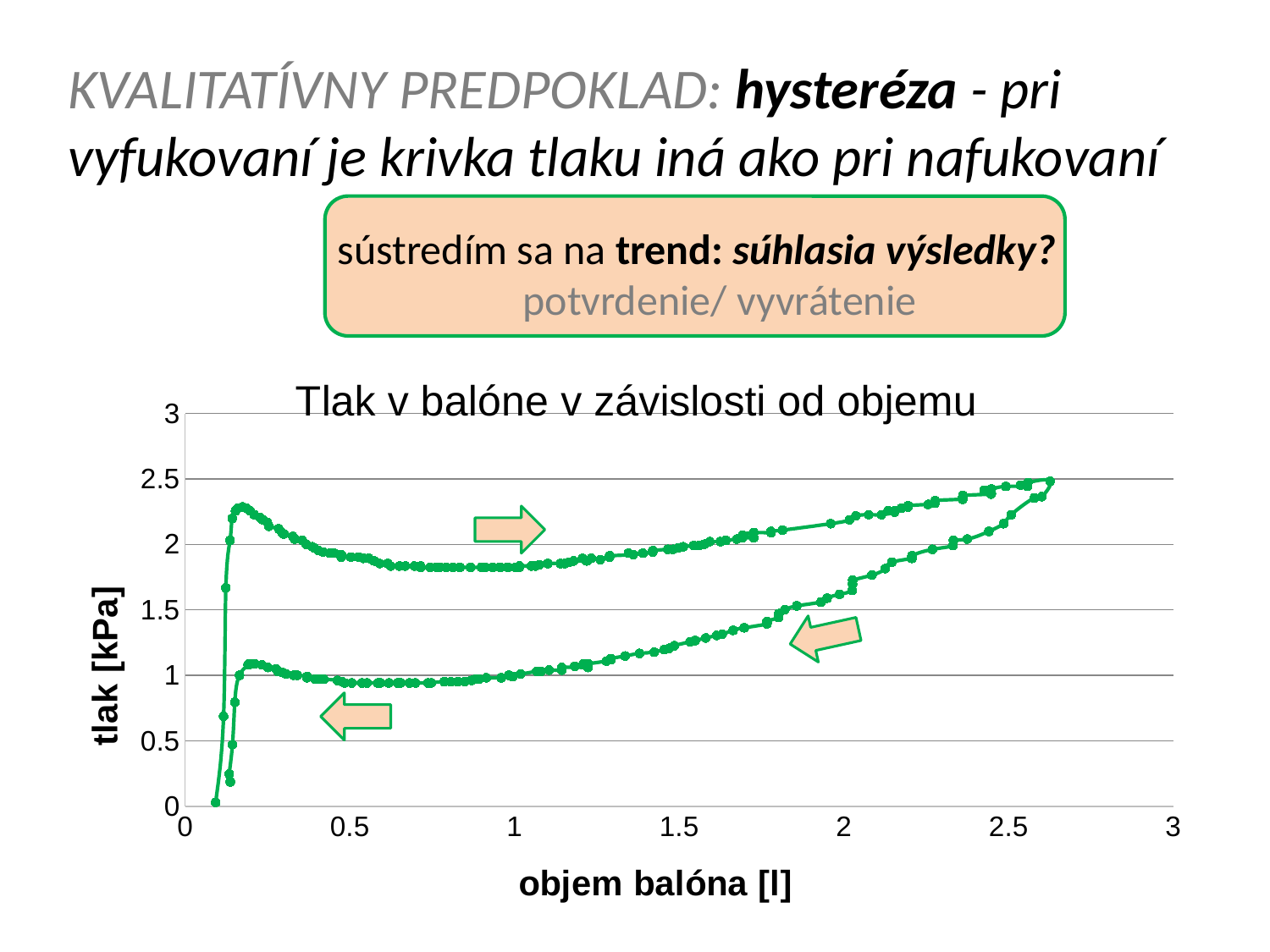
On the upper curve, is the pressure at a volume of 1 l greater or less than 2 kPa? less What is the title of the chart? Tlak v balóne v závislosti od objemu Is the highest pressure reached on the chart greater or less than 2 kPa? greater What is the label of the vertical axis of the chart? tlak [kPa] Is the highest pressure reached on the chart greater or less than 3 kPa? less Along the upper curve, does the pressure rise or fall as the volume increases from 1 l to 2.5 l? rise Along the lower curve, does the pressure rise or fall as the volume increases from 0.5 l to 2.5 l? rise At a volume of 2 l, which curve shows the higher pressure, the upper or the lower one? the upper curve What kind of chart is shown on the slide? line chart